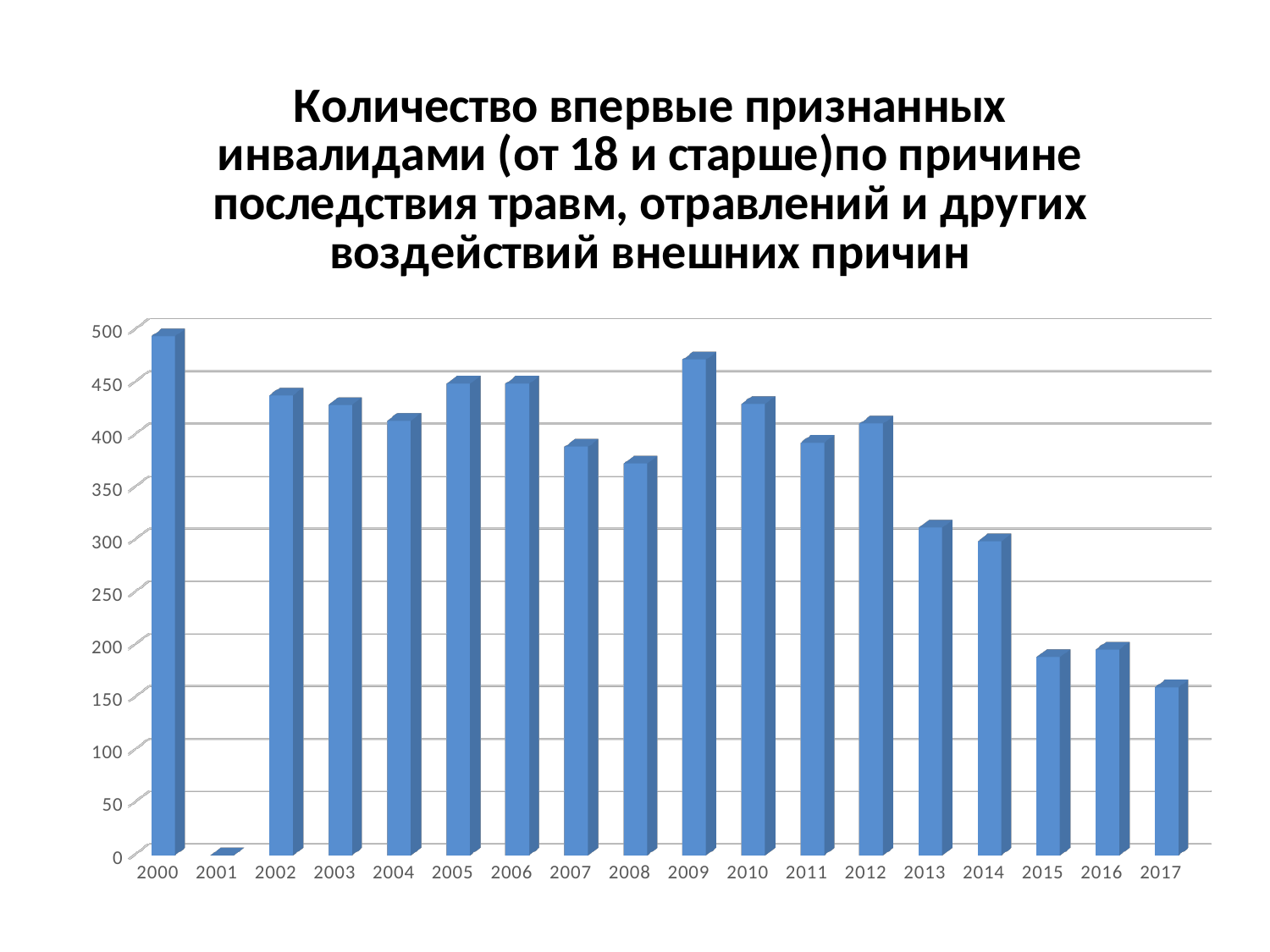
Is the value for 2008 greater or less than 400? less Which is larger, the value for 2009 or the value for 2008? 2009 Which is larger, the value for 2005 or the value for 2017? 2005 Is the value for 2017 greater or less than 200? less Is the value for 2000 greater or less than 450? greater How many years are shown on the x axis of the chart? 18 Which year has the lowest value in the chart? 2001 Do the values generally rise or fall from 2009 to 2017? fall Which year has the highest value in the chart? 2000 What kind of chart is shown on the slide? bar chart